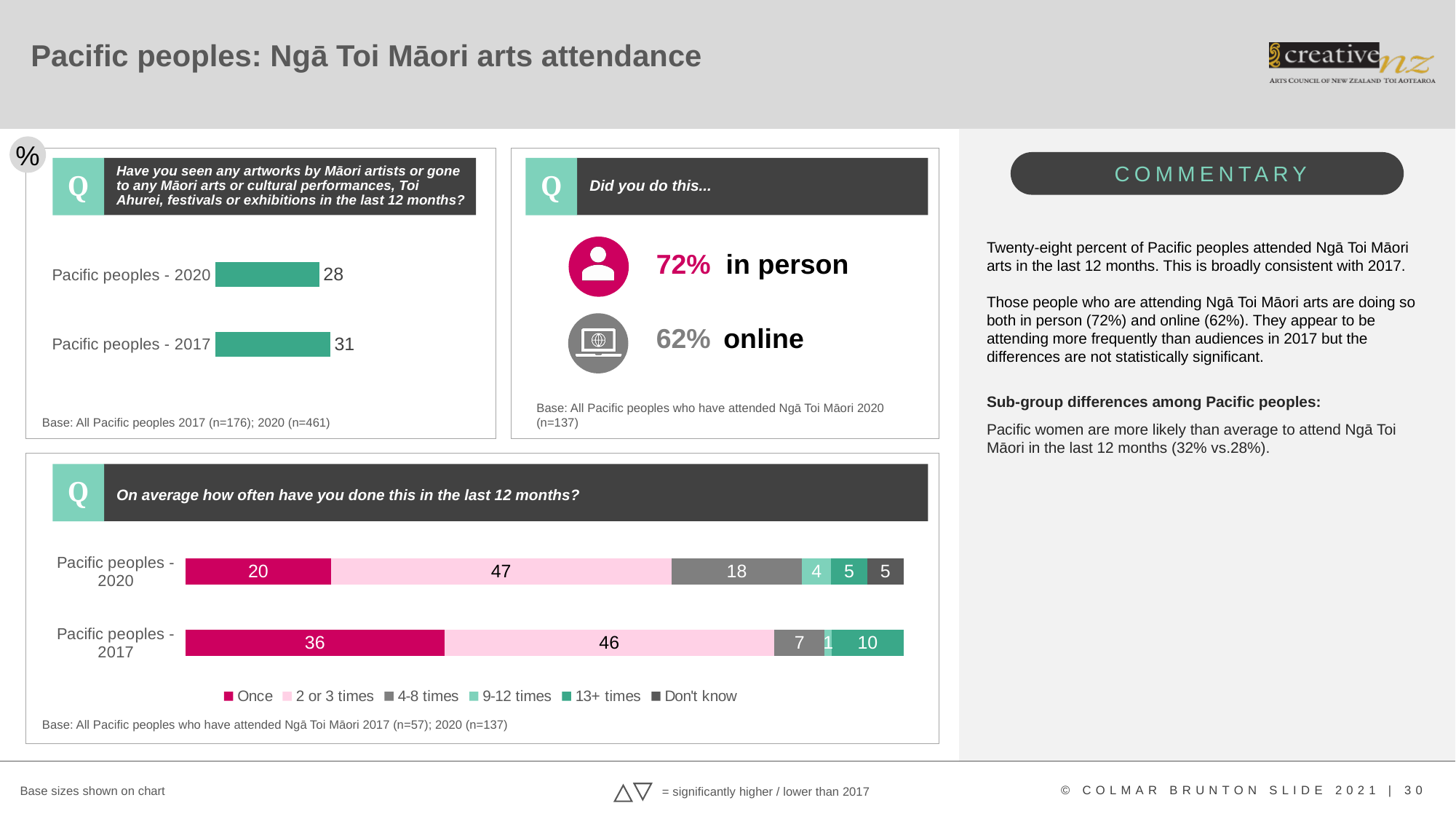
In the chart 'On average how often have you done this in the last 12 months?', how many series does the legend list? 6 What kind of chart is the 'Have you seen any artworks by Māori artists...' chart? Bar chart In the chart 'Have you seen any artworks by Māori artists...', what is the value for Pacific peoples - 2017? 31 In the chart 'On average how often have you done this in the last 12 months?', what is the total of the Pacific peoples - 2020 stacked bar? 99 In the chart 'Have you seen any artworks by Māori artists...', which year has the higher value, 2020 or 2017? 2017 In the chart 'On average how often have you done this in the last 12 months?', what is the value for 'Once' for Pacific peoples - 2017? 36 In the chart 'On average how often have you done this in the last 12 months?', what is the value for '2 or 3 times' for Pacific peoples - 2020? 47 In the chart 'On average how often have you done this in the last 12 months?', what is the value for '13+ times' for Pacific peoples - 2017? 10 In the chart 'On average how often have you done this in the last 12 months?', which segment is the largest for Pacific peoples - 2020? 2 or 3 times In the chart 'Have you seen any artworks by Māori artists or gone to any Māori arts or cultural performances...', what is the value for Pacific peoples - 2020? 28 In the chart 'On average how often have you done this in the last 12 months?', what is the difference between the 'Once' values for 2017 and 2020? 16 In the chart 'Have you seen any artworks by Māori artists...', what is the difference between the 2017 and 2020 values? 3